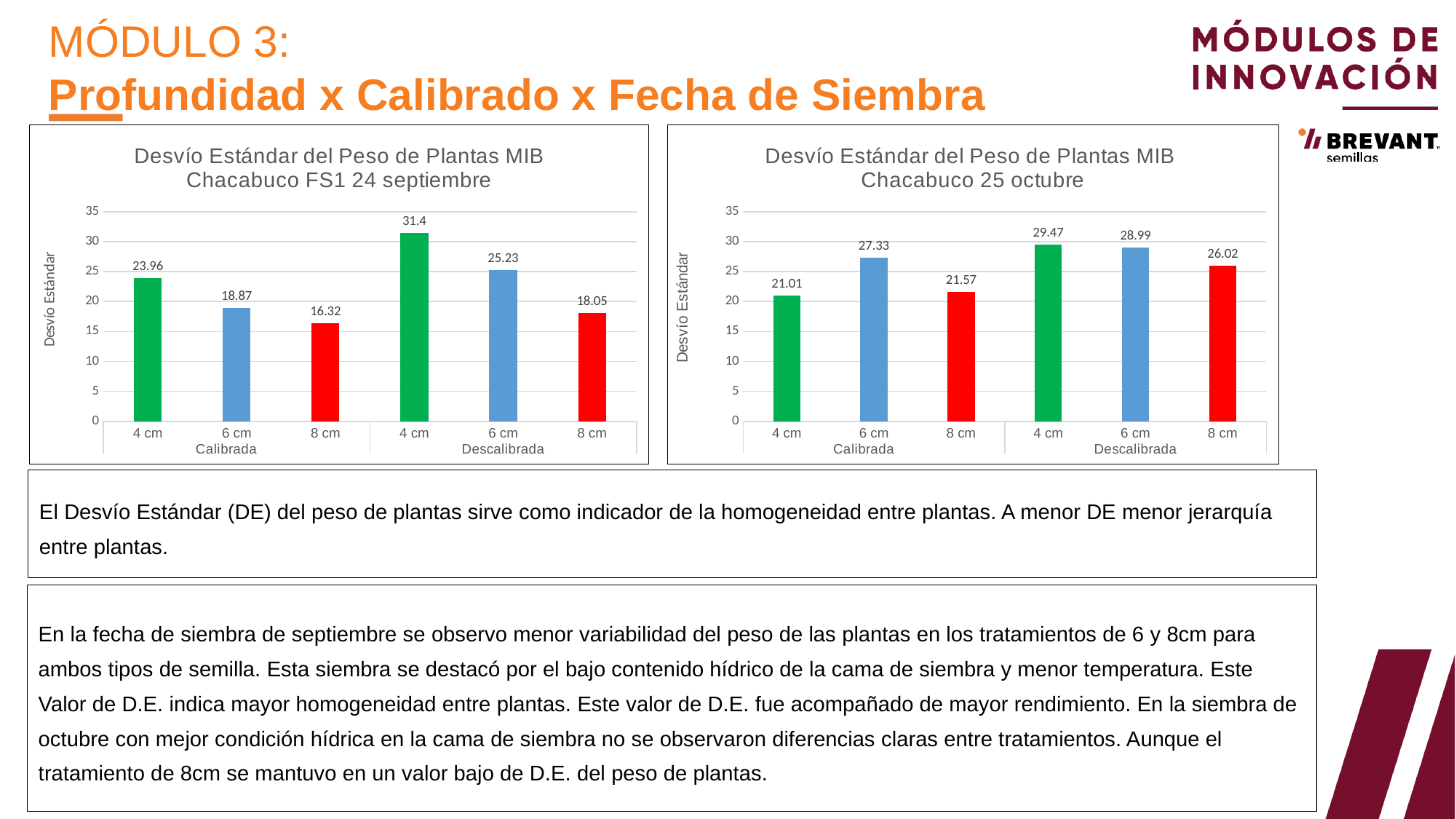
In the chart titled 'Desvío Estándar del Peso de Plantas MIB Chacabuco 25 octubre', what is the value for 6 cm under Calibrada? 27.33 In the chart titled 'Desvío Estándar del Peso de Plantas MIB Chacabuco FS1 24 septiembre', what is the value for 8 cm under Calibrada? 16.32 How many bars are plotted in the left chart (24 septiembre)? 6 In the right chart (25 octubre), what is the difference between the 4 cm Descalibrada value and the 4 cm Calibrada value? 8.46 In the right chart (25 octubre), which is larger: the 8 cm Descalibrada value or the 8 cm Calibrada value? 8 cm Descalibrada In the right chart (25 octubre), which bar has the lowest value? 4 cm Calibrada In the left chart (24 septiembre), what is the difference between the 4 cm Calibrada value and the 6 cm Calibrada value? 5.09 What is the y-axis label of the left chart (24 septiembre)? Desvío Estándar In the left chart (24 septiembre), which bar has the lowest value? 8 cm Calibrada In the chart titled 'Desvío Estándar del Peso de Plantas MIB Chacabuco FS1 24 septiembre', what is the value for 4 cm under Descalibrada? 31.4 What kind of chart is the right chart (25 octubre)? Bar chart In the left chart (24 septiembre), which bar has the highest value? 4 cm Descalibrada